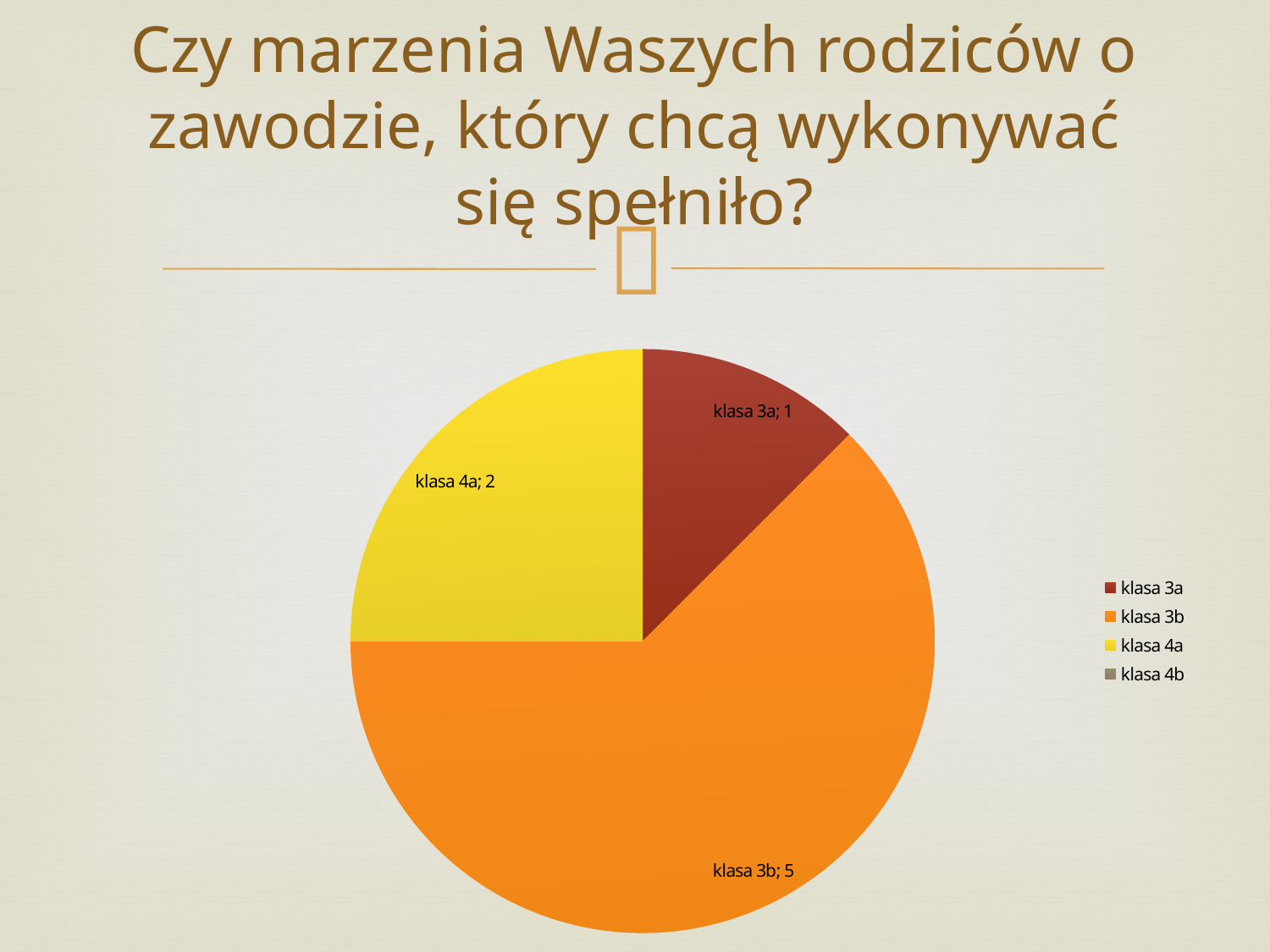
How many entries does the legend list? 4 What kind of chart is shown on the slide? pie chart What is the difference between the values for klasa 4a and klasa 3a? 1 How many slices are visible in the pie chart? 3 What is the value for klasa 3b? 5 What is the difference between the values for klasa 3b and klasa 4a? 3 Which class has the largest slice of the pie? klasa 3b Which class with a visible slice has the smallest value? klasa 3a What is the value for klasa 4a? 2 What colour is the slice for klasa 4a? yellow Which is larger, the value for klasa 4a or the value for klasa 3a? klasa 4a What is the value for klasa 3a? 1